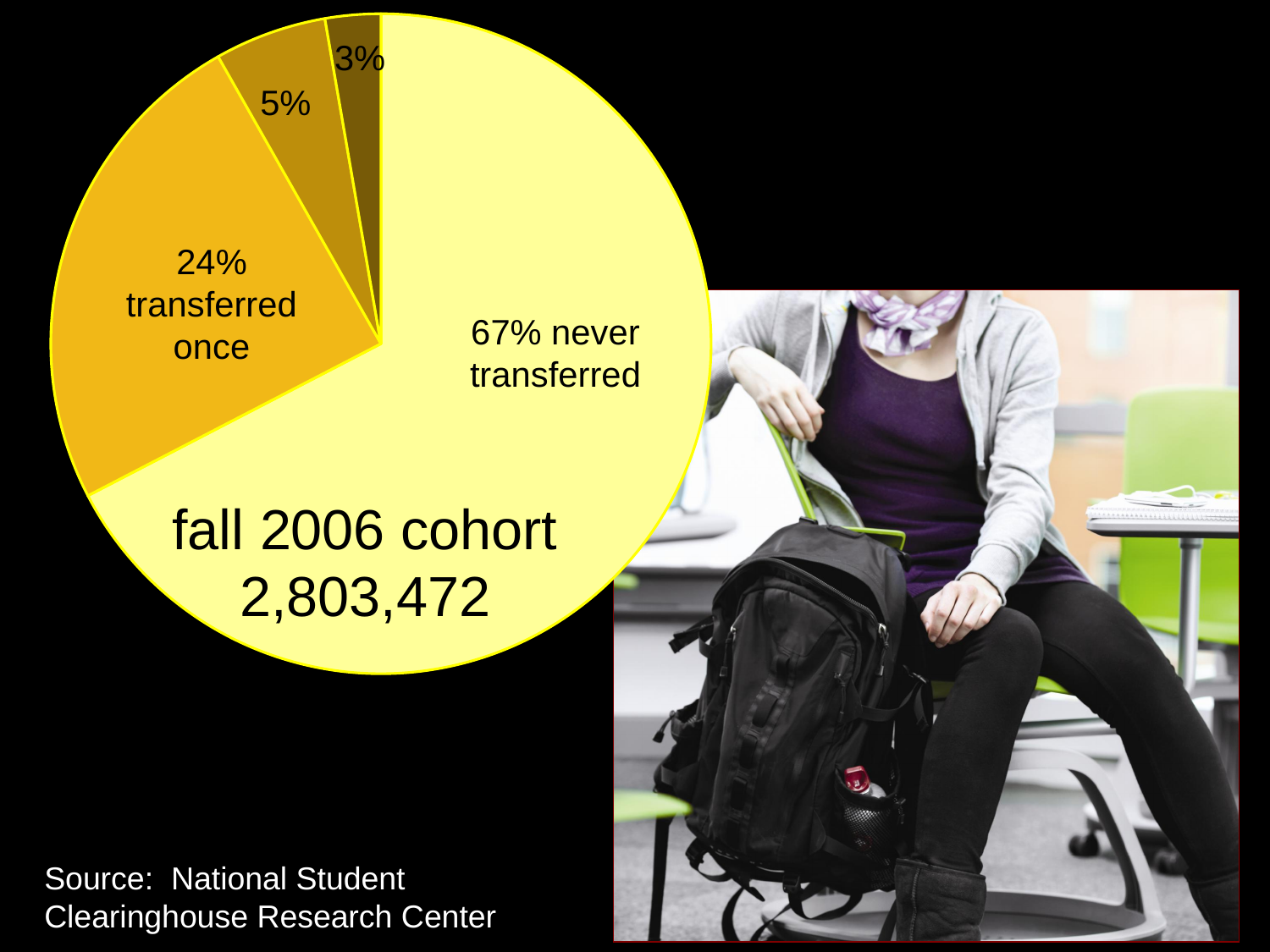
What percentage of the fall 2006 cohort never transferred? 67% What is the difference in percentage points between the 'never transferred' slice and the 'transferred once' slice? 43 percentage points What percentage of the fall 2006 cohort transferred once? 24% Is the share of students who transferred once greater or less than 30%? less Which cohort does the pie chart describe? fall 2006 cohort How many students are in the fall 2006 cohort shown on the pie chart? 2,803,472 What is the difference in percentage points between the 24% slice and the 5% slice? 19 percentage points What is the source of the data shown in the pie chart? National Student Clearinghouse Research Center Which is larger, the 5% slice or the 3% slice? the 5% slice What kind of chart is shown on the slide? pie chart Is the share of students who never transferred greater or less than 50%? greater Which slice of the pie chart is the largest? 67% never transferred